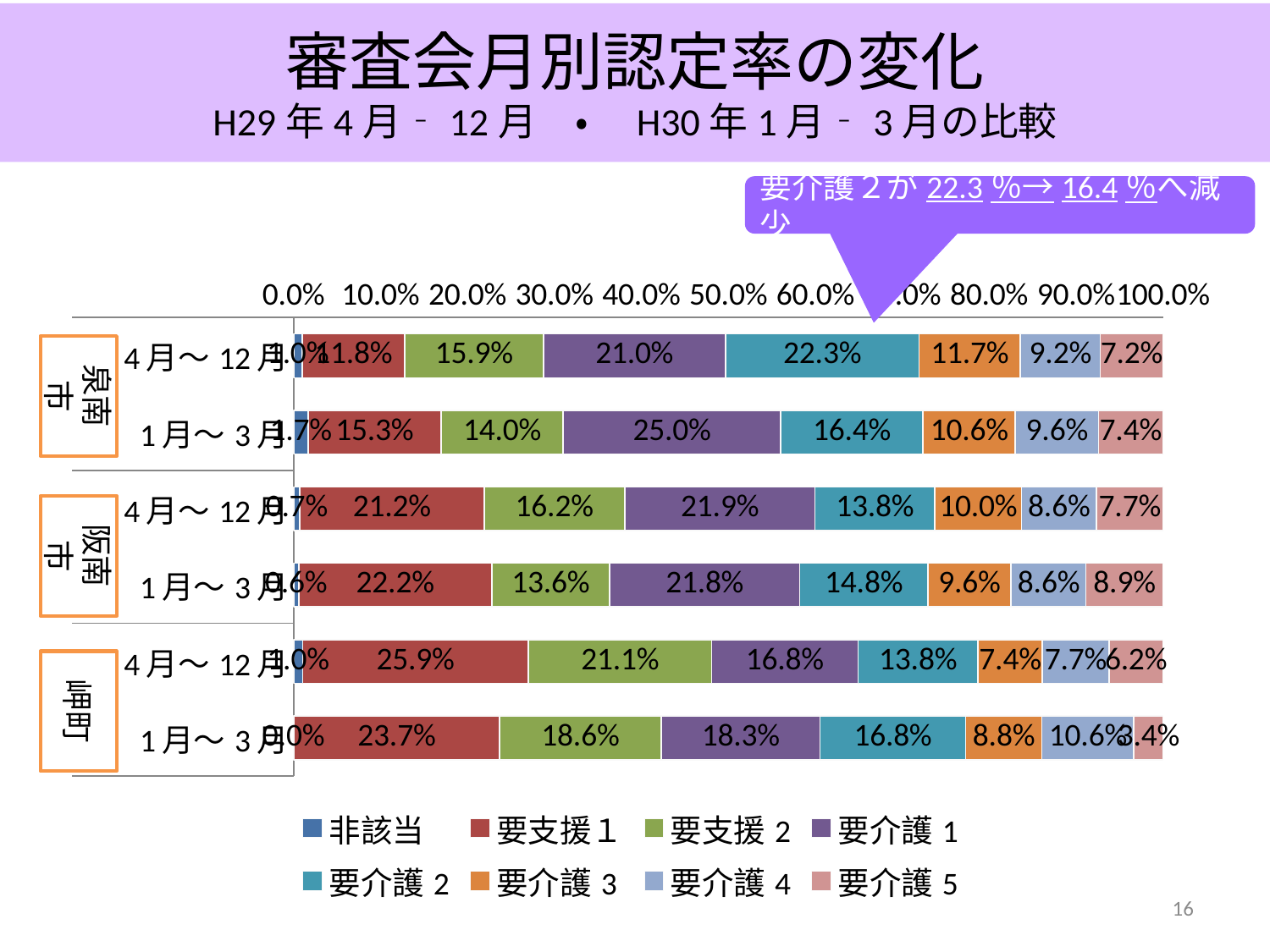
Which series has the smallest share in the 岬町 1月〜3月 bar? 非該当 What is the 要介護1 value for 阪南市 in 1月〜3月? 21.8% By how much did the 要介護2 share for 泉南市 change from 4月〜12月 to 1月〜3月? 5.9% Which series has the largest share in the 泉南市 1月〜3月 bar? 要介護1 What is the title of the chart slide? 審査会月別認定率の変化 What is the 要支援1 value for 岬町 in 4月〜12月? 25.9% How many series does the legend list? 8 Which is larger for 阪南市 in 4月〜12月: 要支援1 or 要介護1? 要介護1 What is the 要介護2 value for 泉南市 in 1月〜3月? 16.4% What is the 要介護2 value for 泉南市 in 4月〜12月? 22.3% What kind of chart is shown on the slide? Stacked bar chart How many bars are plotted in the chart? 6